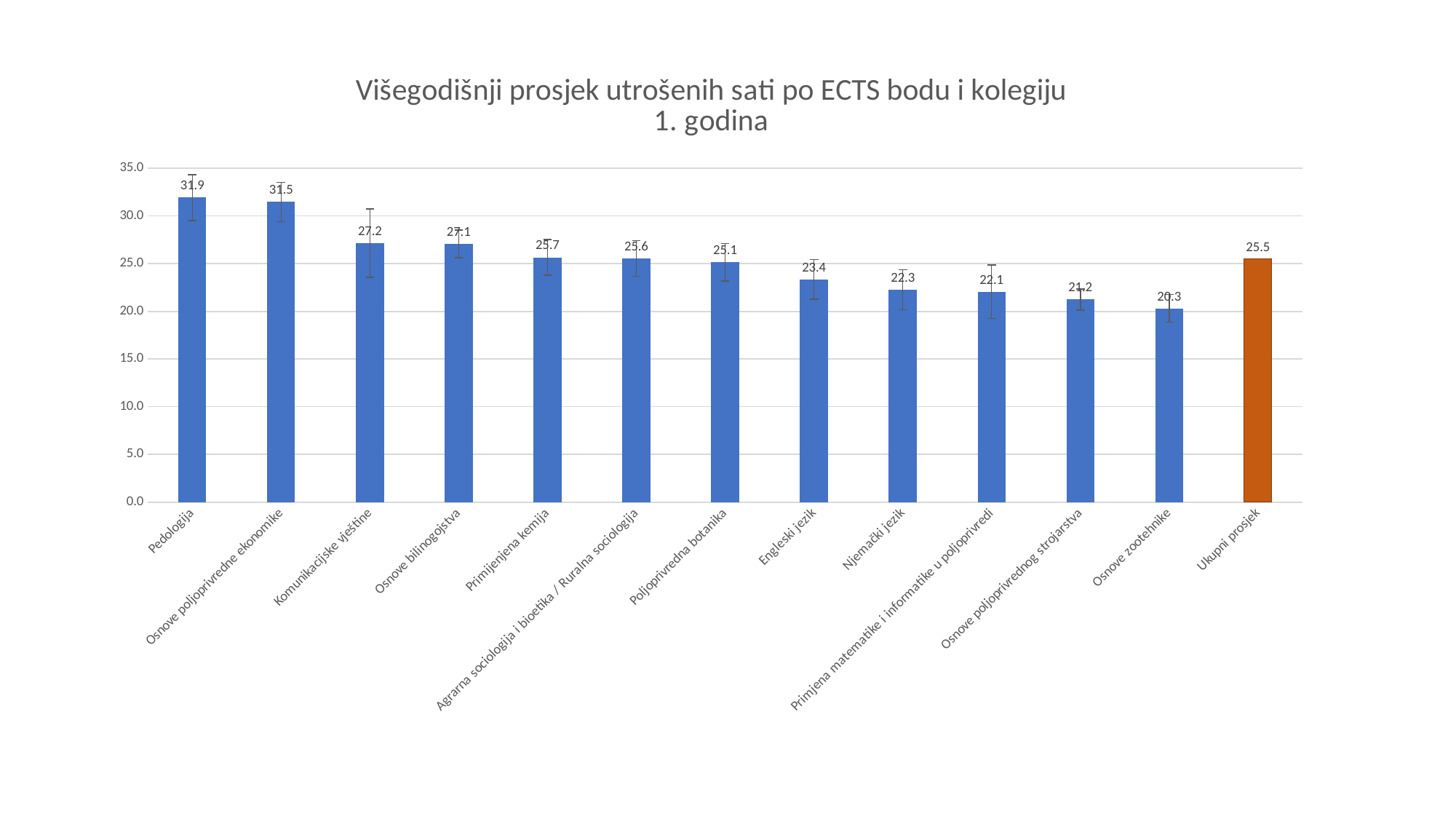
What is the value for Osnove zootehnike? 20.3 What is the value for Pedologija? 31.9 Which category has the highest value? Pedologija How many bars are shown in the chart? 13 What kind of chart is shown on the slide? Bar chart What is the difference between the values for Komunikacijske vještine and Njemački jezik? 4.9 What is the difference between the values for Pedologija and Osnove zootehnike? 11.6 What is the title of the chart? Višegodišnji prosjek utrošenih sati po ECTS bodu i kolegiju 1. godina What is the value for Engleski jezik? 23.4 What is the value for Ukupni prosjek? 25.5 Which category has the lowest value? Osnove zootehnike Which is larger, the value for Primijenjena kemija or the value for Poljoprivredna botanika? Primijenjena kemija